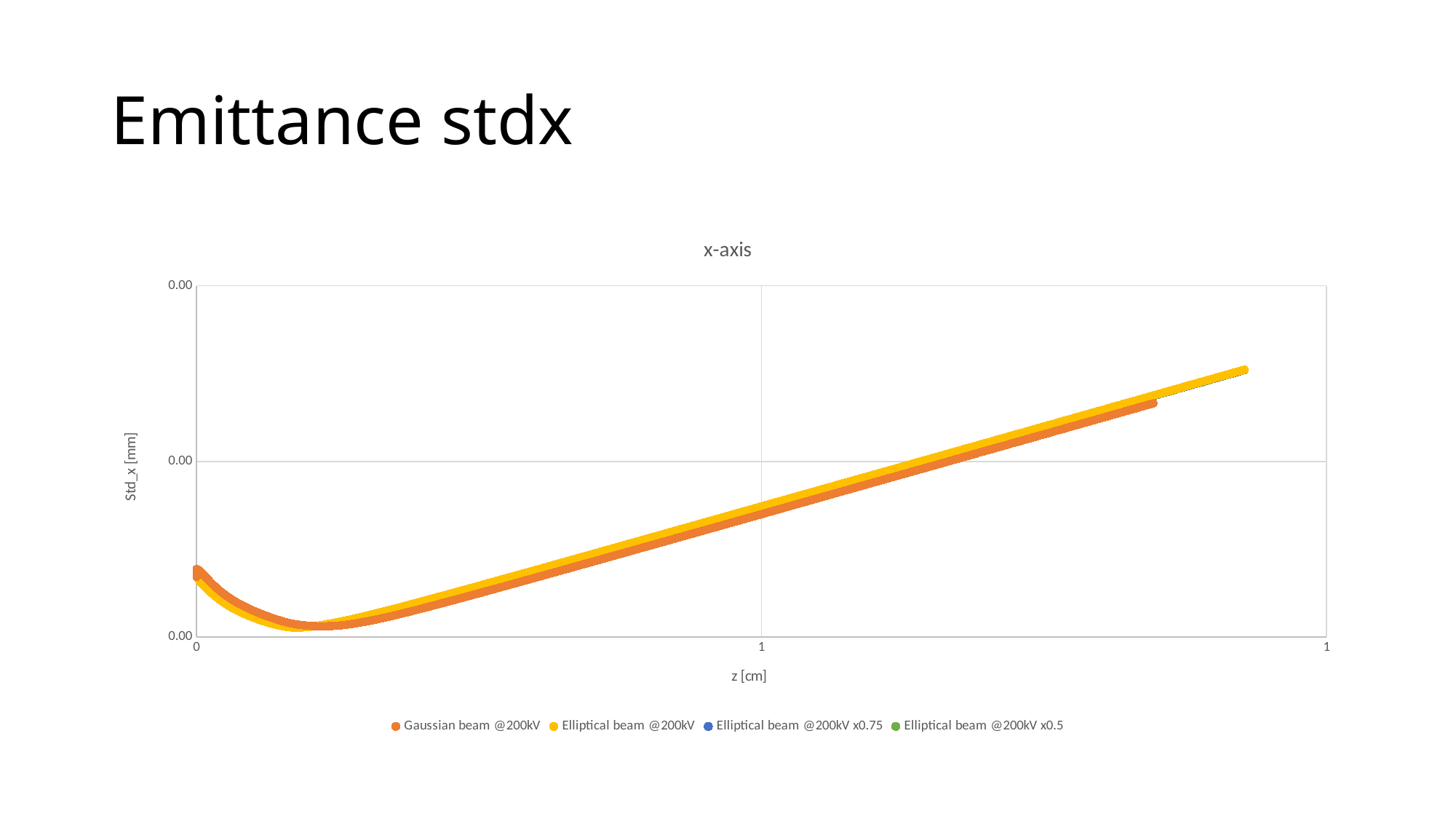
How many series does the legend list? 4 Do the Std_x values fall or rise over the first short stretch of z starting from 0? fall What is the title of the chart? x-axis What kind of chart is shown on the slide? scatter chart After the initial dip near the left, do the Std_x values rise or fall as z increases? rise Is the minimum of the plotted curves located near the left end or the right end of the z axis? left end What is the label of the vertical axis? Std_x [mm] Which series is drawn in orange? Gaussian beam @200kV